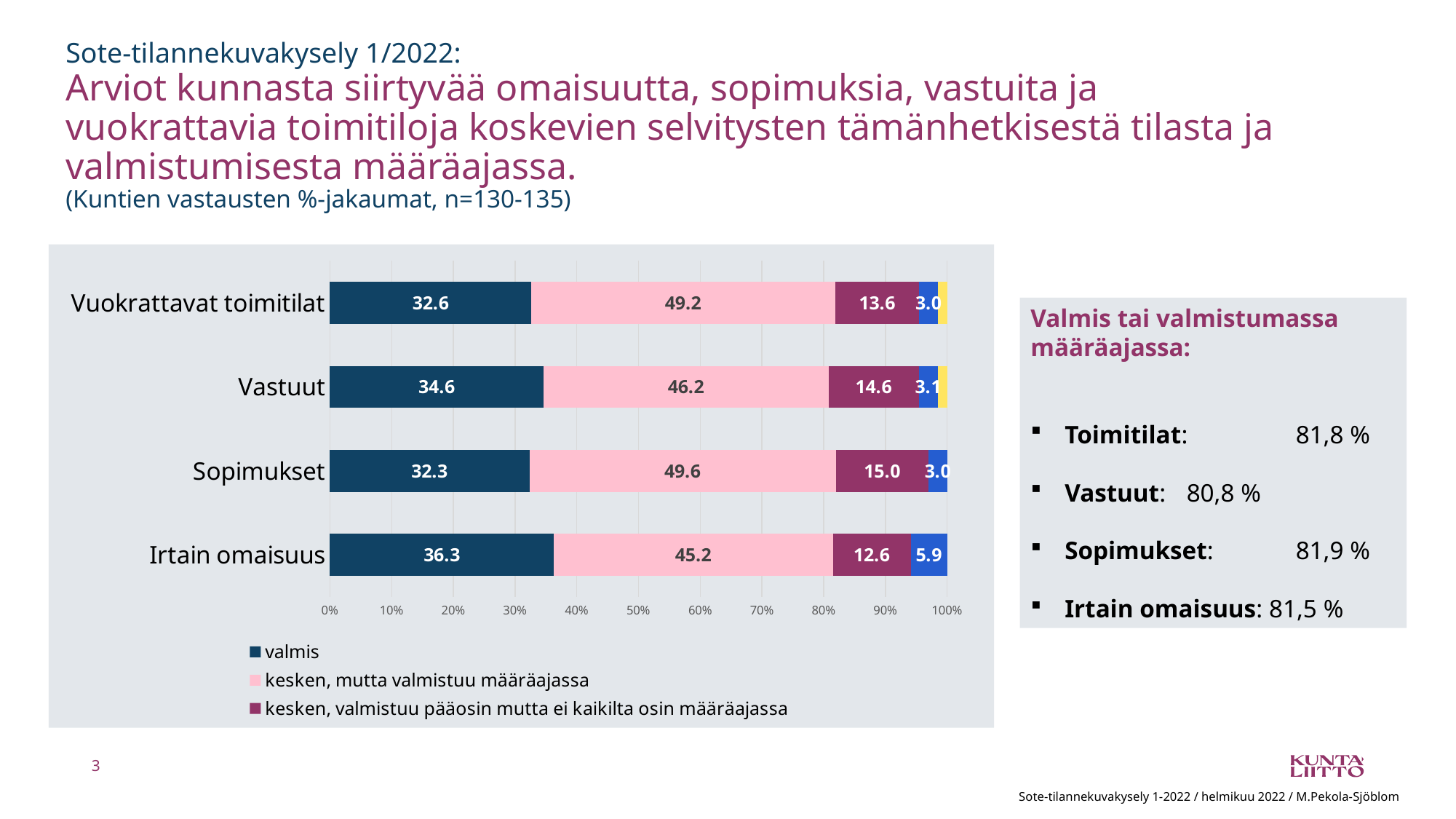
What colour represents the 'valmis' series in the chart? dark blue What type of chart is shown on the slide? stacked bar chart Which is larger: the 'kesken, valmistuu pääosin mutta ei kaikilta osin määräajassa' value for Sopimukset or for Vuokrattavat toimitilat? Sopimukset What is the 'kesken, valmistuu pääosin mutta ei kaikilta osin määräajassa' value for Vastuut? 14.6 What is the 'valmis' value for Irtain omaisuus? 36.3 Which category has the lowest 'kesken, mutta valmistuu määräajassa' value? Irtain omaisuus How many series does the chart's legend list? 3 Is the 'valmis' value for Vuokrattavat toimitilat greater or less than 30%? greater Which category has the highest 'valmis' value? Irtain omaisuus How many categories are shown on the chart? 4 What is the difference between the 'valmis' values for Vastuut and Sopimukset? 2.3 What is the 'kesken, mutta valmistuu määräajassa' value for Sopimukset? 49.6